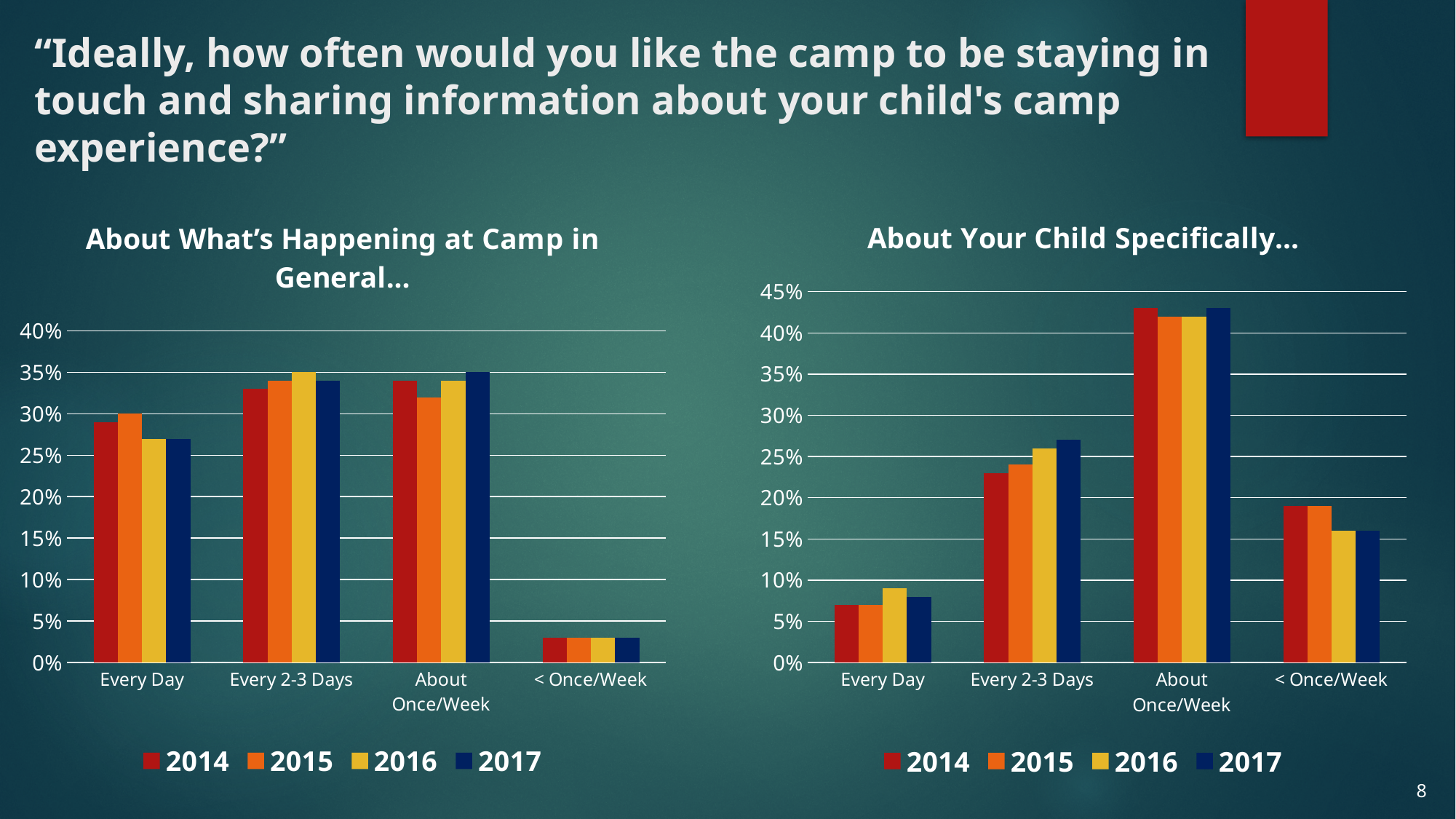
What colour represents the 2017 series in the legend of the right chart, 'About Your Child Specifically…'? dark blue What kind of chart is the left chart, 'About What's Happening at Camp in General…'? bar chart In the right chart, 'About Your Child Specifically…', is the 2016 value for Every Day greater or less than 10%? less In the right chart, 'About Your Child Specifically…', is the 2017 value for Every 2-3 Days greater or less than 25%? greater In the left chart, 'About What's Happening at Camp in General…', is the 2014 value for < Once/Week greater or less than 5%? less In the left chart, 'About What's Happening at Camp in General…', which category has the lowest value for 2017? < Once/Week How many series does the legend of the right chart, 'About Your Child Specifically…', list? 4 In the right chart, 'About Your Child Specifically…', which is larger for < Once/Week: the 2014 value or the 2016 value? 2014 In the right chart, 'About Your Child Specifically…', do the values for Every 2-3 Days rise or fall from 2014 to 2017? rise How many categories are shown on the x axis of the left chart, 'About What's Happening at Camp in General…'? 4 In the right chart, 'About Your Child Specifically…', which category has the highest value for 2014? About Once/Week